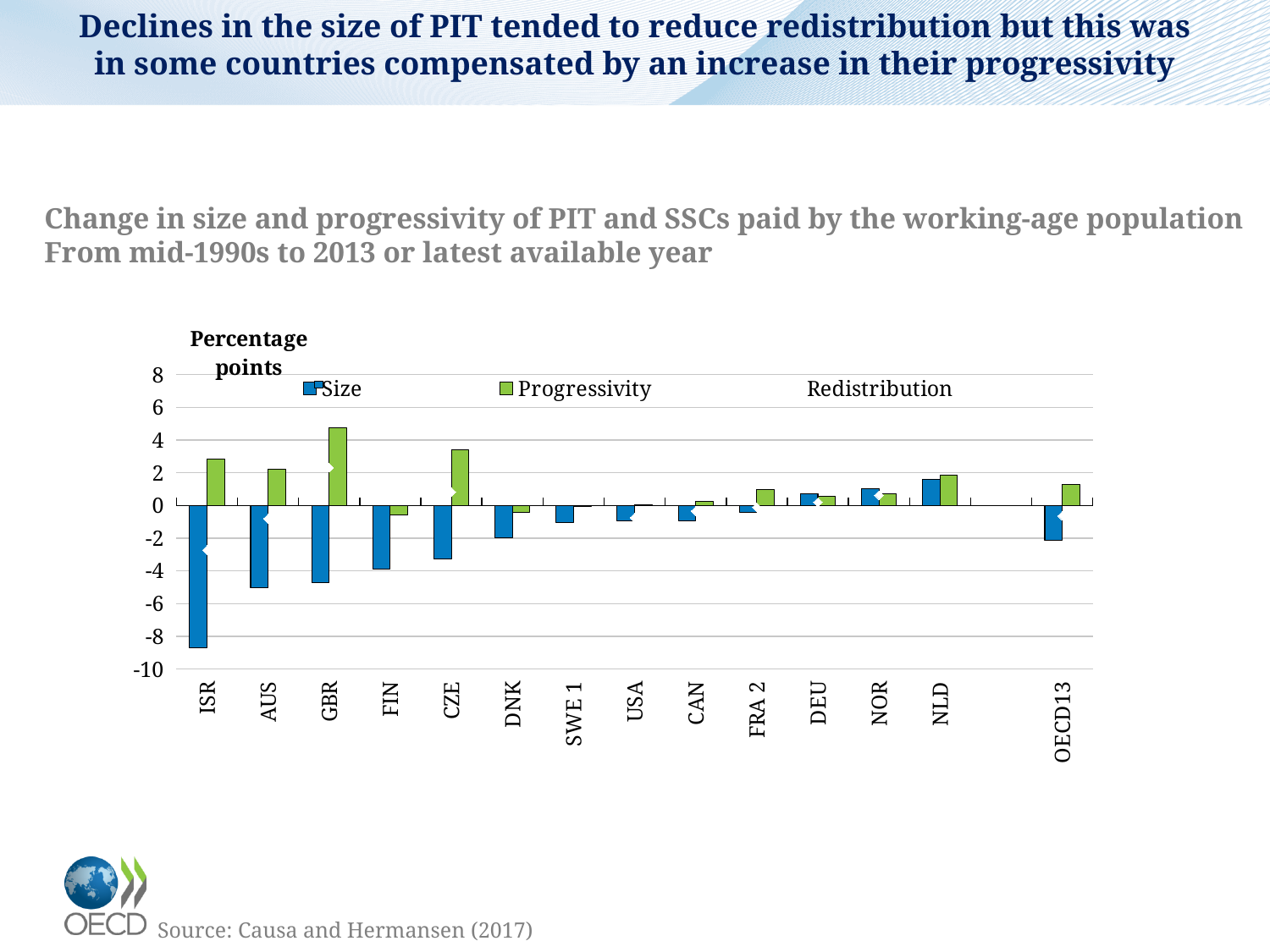
Which country has the lowest value for Size? ISR What kind of chart is shown on the slide? bar chart What unit is shown on the y axis of the chart? Percentage points Which country has the highest value for Progressivity? GBR Which has the larger Progressivity value, ISR or AUS? ISR Is the Size value for AUS greater or less than -4? less How many countries or groups are shown on the x axis? 14 Which country has the highest value for Size? NLD How many series does the legend list? 3 Is the Size value for ISR greater or less than -8? less Is the Progressivity value for GBR greater or less than 4? greater